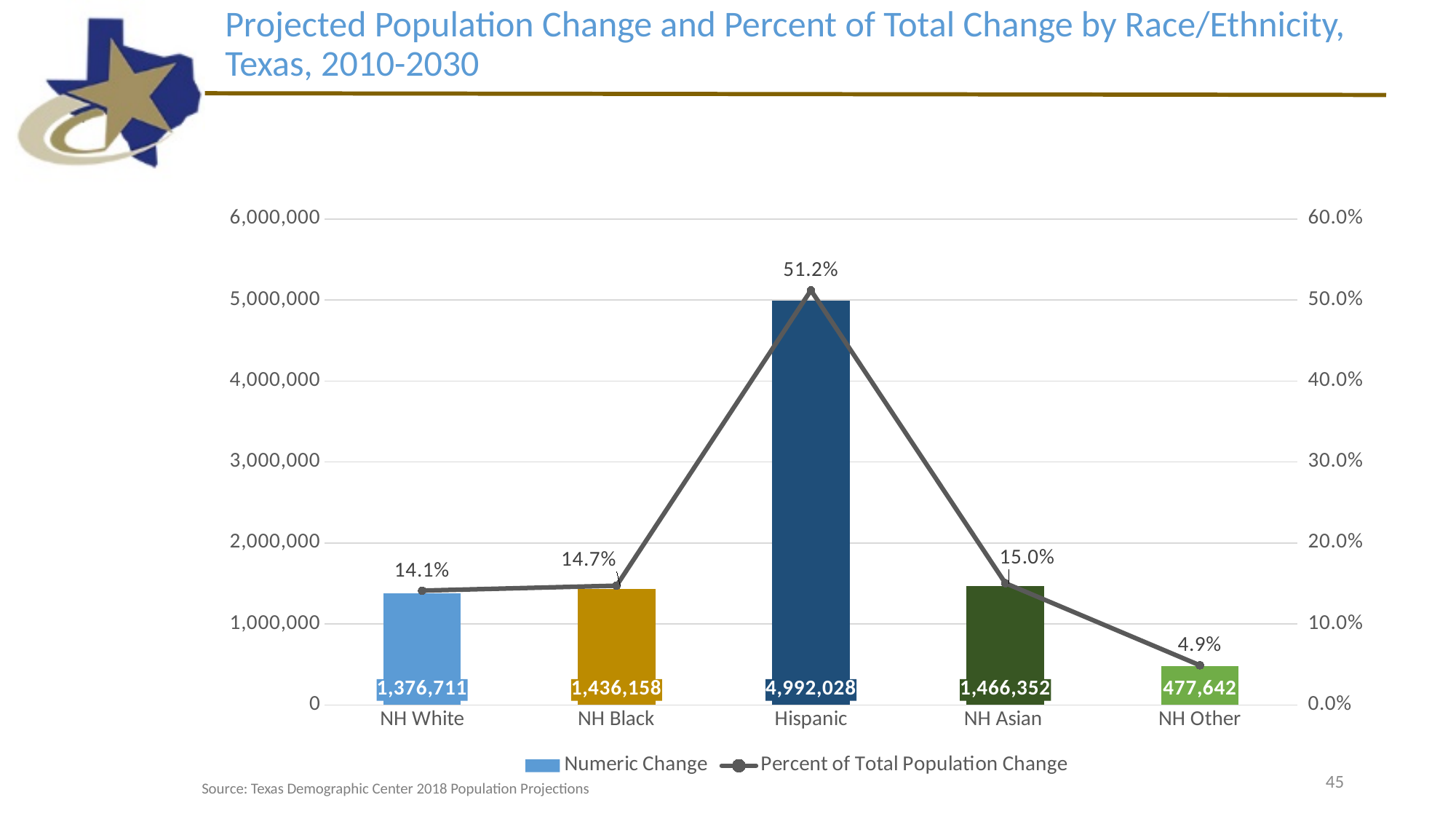
What is the projected numeric change for Hispanic? 4,992,028 Which race/ethnicity group has the smallest percent of total population change? NH Other What percent of total population change is attributed to NH White? 14.1% What is the projected numeric change for NH Other? 477,642 How many race/ethnicity categories are shown on the x axis? 5 Which race/ethnicity group has the largest projected numeric change? Hispanic Which has the larger numeric change, NH Black or NH White? NH Black Is the numeric change for NH Other greater or less than 1,000,000? less What percent of total population change is attributed to NH Asian? 15.0% What is the difference in numeric change between Hispanic and NH White? 3,615,317 How many series does the legend list? 2 What kind of chart is used to show Numeric Change? Bar chart